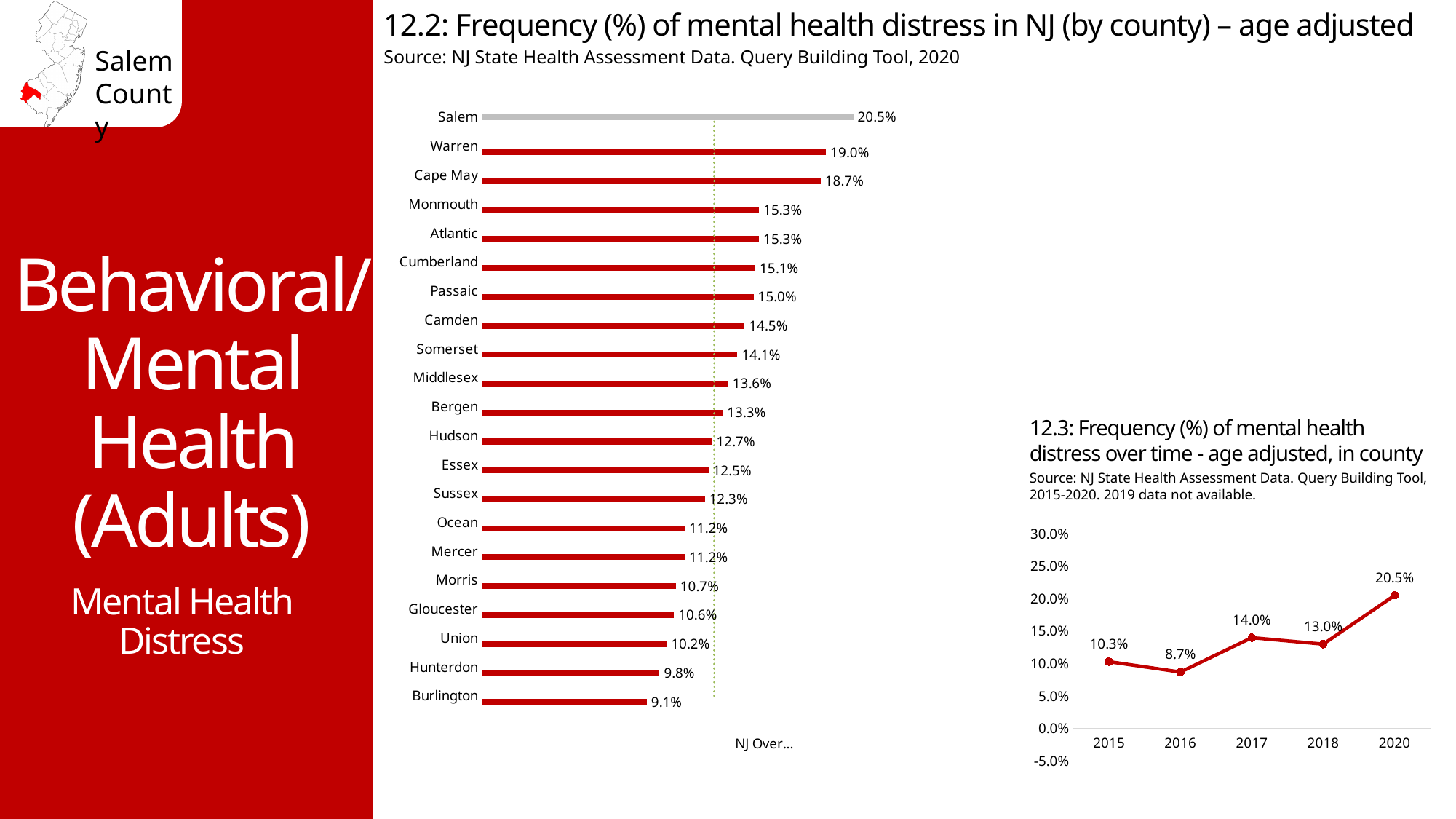
In chart 12.2 (frequency of mental health distress by county), what is the difference between Salem and Warren? 1.5% In chart 12.2 (frequency of mental health distress by county), which county has the lowest value? Burlington In chart 12.2 (frequency of mental health distress by county), what is the value for Cape May? 18.7% What kind of chart is chart 12.3 (mental health distress over time)? Line chart In chart 12.3 (mental health distress over time), what is the difference between the 2020 and 2018 values? 7.5% In chart 12.2 (frequency of mental health distress by county), what is the value for Salem? 20.5% In chart 12.2 (frequency of mental health distress by county), which county has the highest value? Salem What kind of chart is chart 12.2 (frequency of mental health distress by county)? Bar chart In chart 12.2 (frequency of mental health distress by county), how many counties are shown? 21 In chart 12.3 (mental health distress over time), what is the value for 2016? 8.7% In chart 12.3 (mental health distress over time), which year has the highest value? 2020 In chart 12.2 (frequency of mental health distress by county), which is larger, the value for Camden or the value for Somerset? Camden